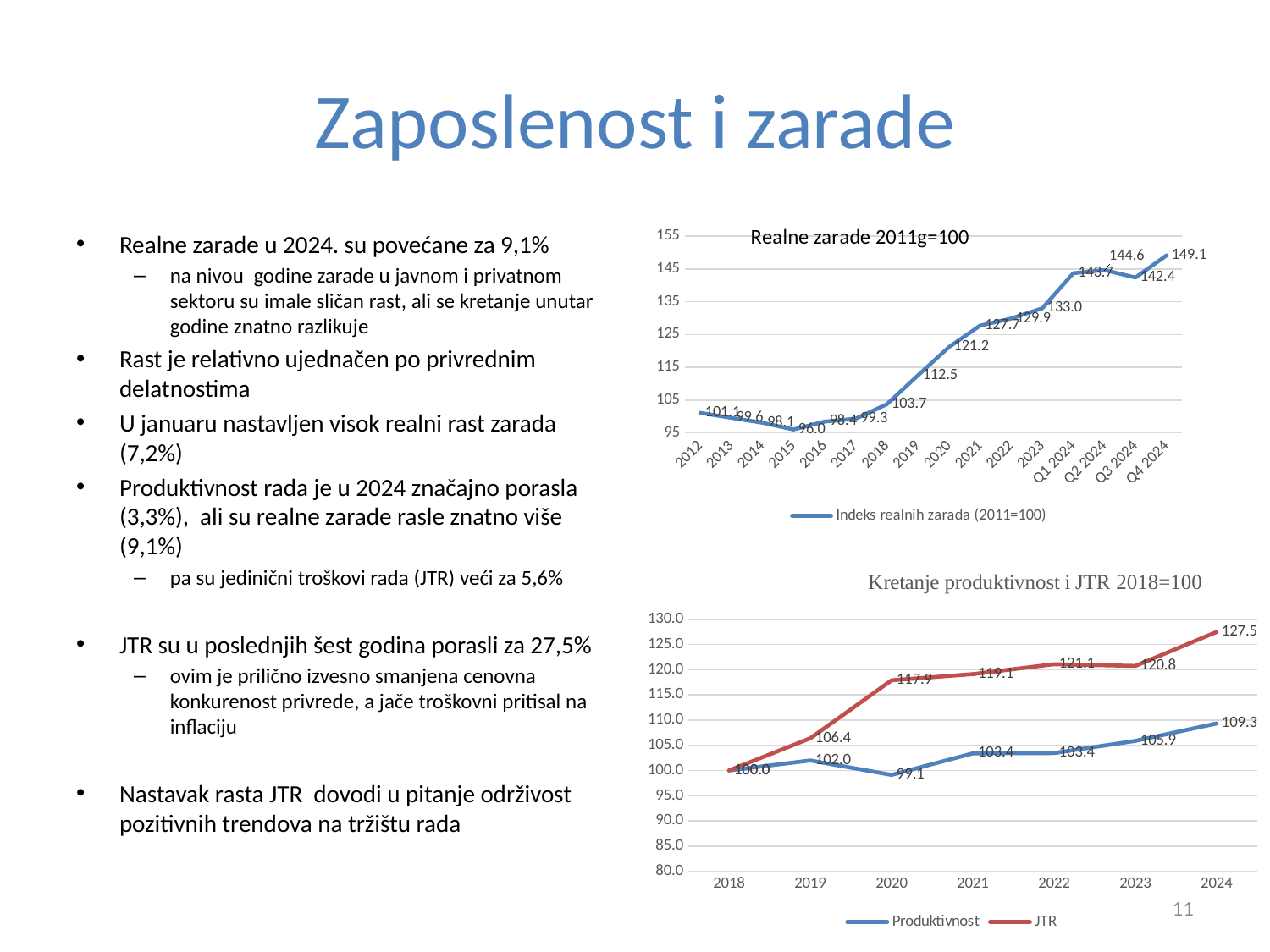
In the chart titled "Realne zarade 2011g=100", which category has the lowest value? 2015 In the chart titled "Kretanje produktivnost i JTR 2018=100", what is the Produktivnost value for 2020? 99.1 In the chart titled "Kretanje produktivnost i JTR 2018=100", what is the difference between the JTR and Produktivnost values in 2024? 18.2 In the chart titled "Realne zarade 2011g=100", how many data points are plotted? 16 In the chart titled "Kretanje produktivnost i JTR 2018=100", what is the JTR value for 2024? 127.5 In the chart titled "Realne zarade 2011g=100", which category has the highest value? Q4 2024 In the chart titled "Kretanje produktivnost i JTR 2018=100", which series has the larger value in 2022, Produktivnost or JTR? JTR In the chart titled "Realne zarade 2011g=100", what kind of chart is it? Line chart In the chart titled "Kretanje produktivnost i JTR 2018=100", how many series does the legend list? 2 In the chart titled "Realne zarade 2011g=100", what is the difference between the values for 2023 and 2018? 29.3 In the chart titled "Realne zarade 2011g=100", what is the value for 2019? 112.5 In the chart titled "Realne zarade 2011g=100", what is the value for Q4 2024? 149.1